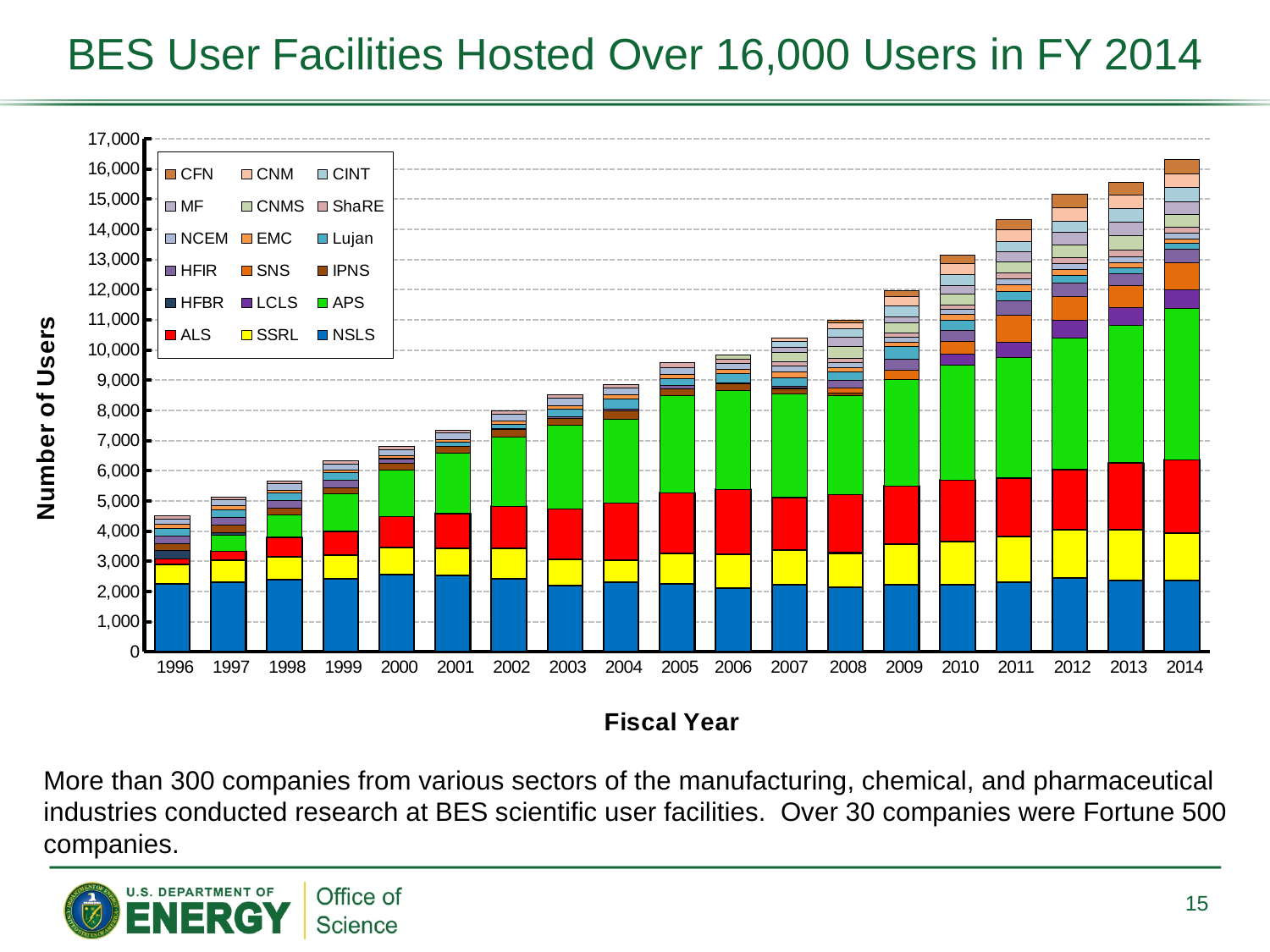
What is the label of the x axis of the chart? Fiscal Year Is the total number of users in 2005 greater or less than 10,000? less Is the total number of users in 1996 greater or less than 5,000? less Which fiscal year has the lowest total number of users? 1996 Do the total number of users generally rise or fall from 1996 to 2014? Rise Is the total number of users in 2014 greater or less than 16,000? greater Which fiscal year has a larger total number of users, 2004 or 2008? 2008 Which fiscal year has the highest total number of users? 2014 How many fiscal years are shown along the x axis of the chart? 19 What kind of chart is shown on the slide? Stacked bar chart What is the label of the y axis of the chart? Number of Users How many series (facilities) does the chart legend list? 18